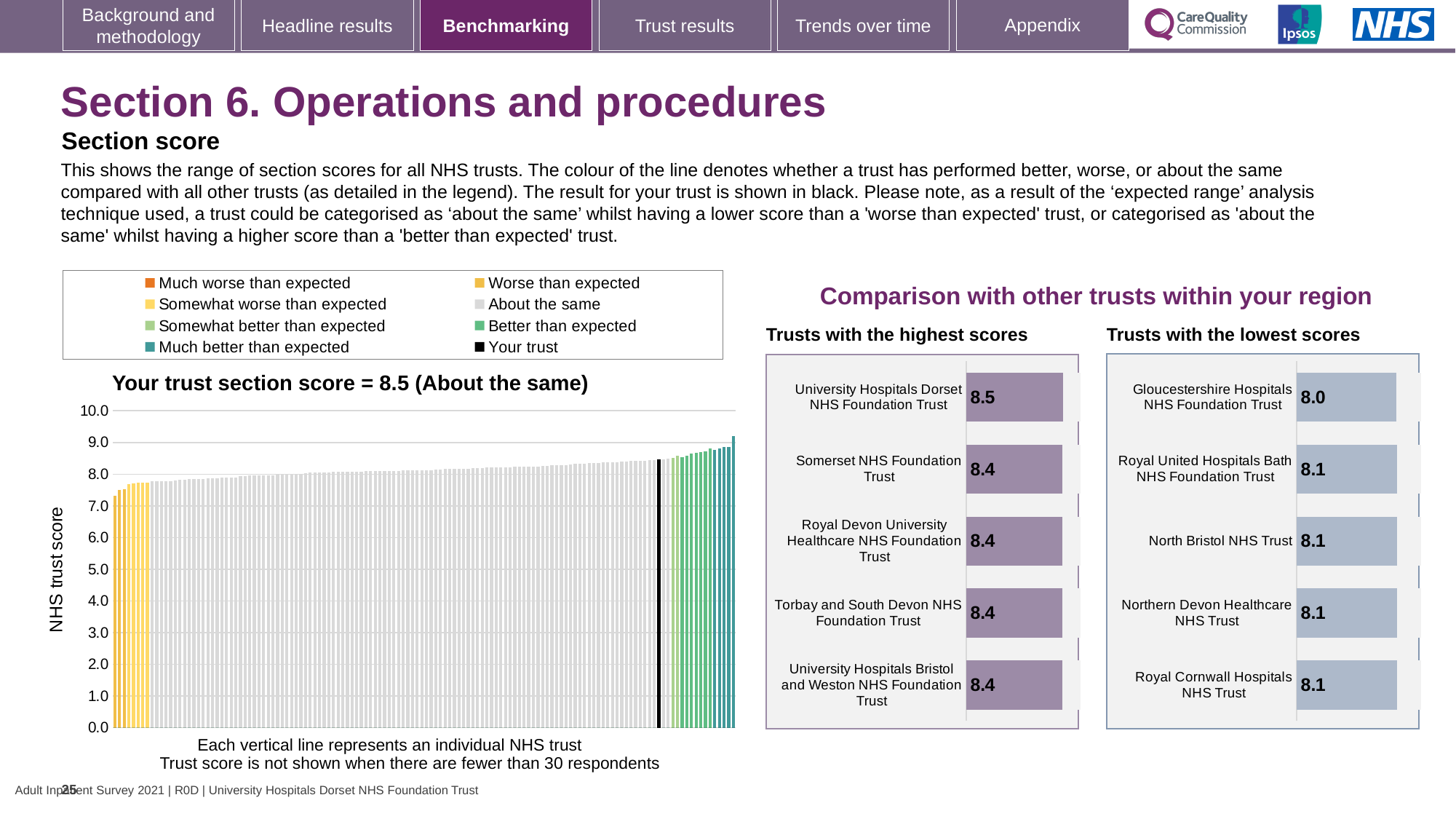
In the 'Your trust section score' chart, what is the section score for your trust? 8.5 In the 'Trusts with the highest scores' chart, which trust has the highest score? University Hospitals Dorset NHS Foundation Trust In the 'Trusts with the highest scores' chart, how many trusts are listed? 5 In the 'Trusts with the lowest scores' chart, which trust has the lowest score? Gloucestershire Hospitals NHS Foundation Trust In the 'Your trust section score' chart, what is the label on the vertical axis? NHS trust score In the 'Trusts with the highest scores' chart, what is the difference between the scores of University Hospitals Dorset NHS Foundation Trust and Somerset NHS Foundation Trust? 0.1 In the 'Trusts with the highest scores' chart, what is the score for University Hospitals Dorset NHS Foundation Trust? 8.5 In the 'Trusts with the lowest scores' chart, which has the larger score: Gloucestershire Hospitals NHS Foundation Trust or Royal Cornwall Hospitals NHS Trust? Royal Cornwall Hospitals NHS Trust In the 'Your trust section score' chart, do the bars rise or fall from left to right? Rise In the 'Your trust section score' chart, how many entries does the legend list? 8 In the 'Your trust section score' chart, is the value of the leftmost (lowest) bar greater or less than 8.0? less In the 'Your trust section score' chart, what kind of chart is shown? Bar chart